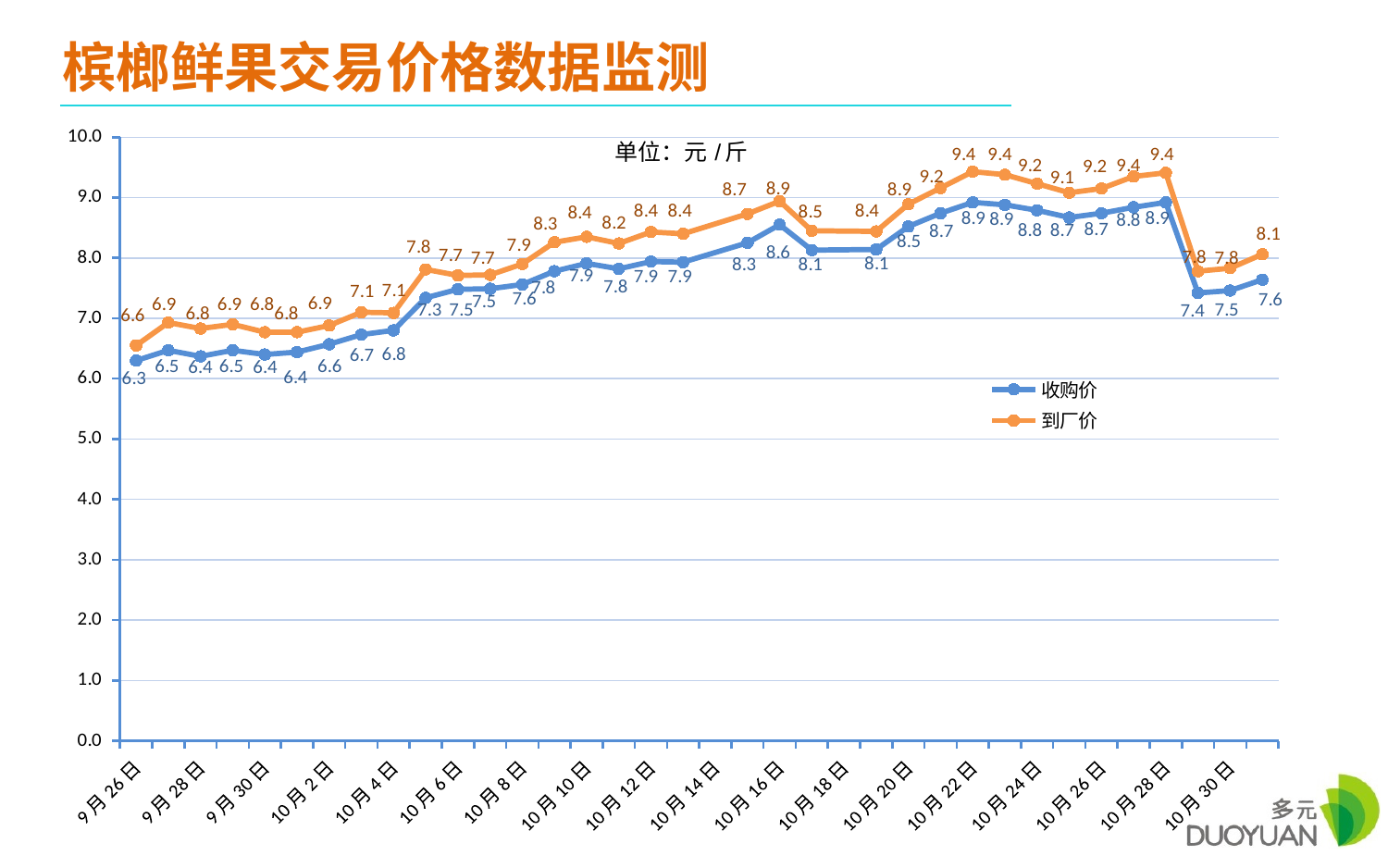
What is the highest 收购价 value shown on the chart? 8.9 What is the 到厂价 value on 9月26日? 6.6 What are the two series named in the legend? 收购价 and 到厂价 Is the lowest 到厂价 value greater or less than 7.0? less What is the difference between 到厂价 and 收购价 on 9月26日? 0.3 How many series does the legend list? 2 What is the highest 到厂价 value shown on the chart? 9.4 What is the lowest 收购价 value shown on the chart? 6.3 What type of chart is shown on the slide? line chart What is the 收购价 value on 9月26日? 6.3 What unit is stated on the chart? 元/斤 Which series is consistently higher across the chart, 收购价 or 到厂价? 到厂价